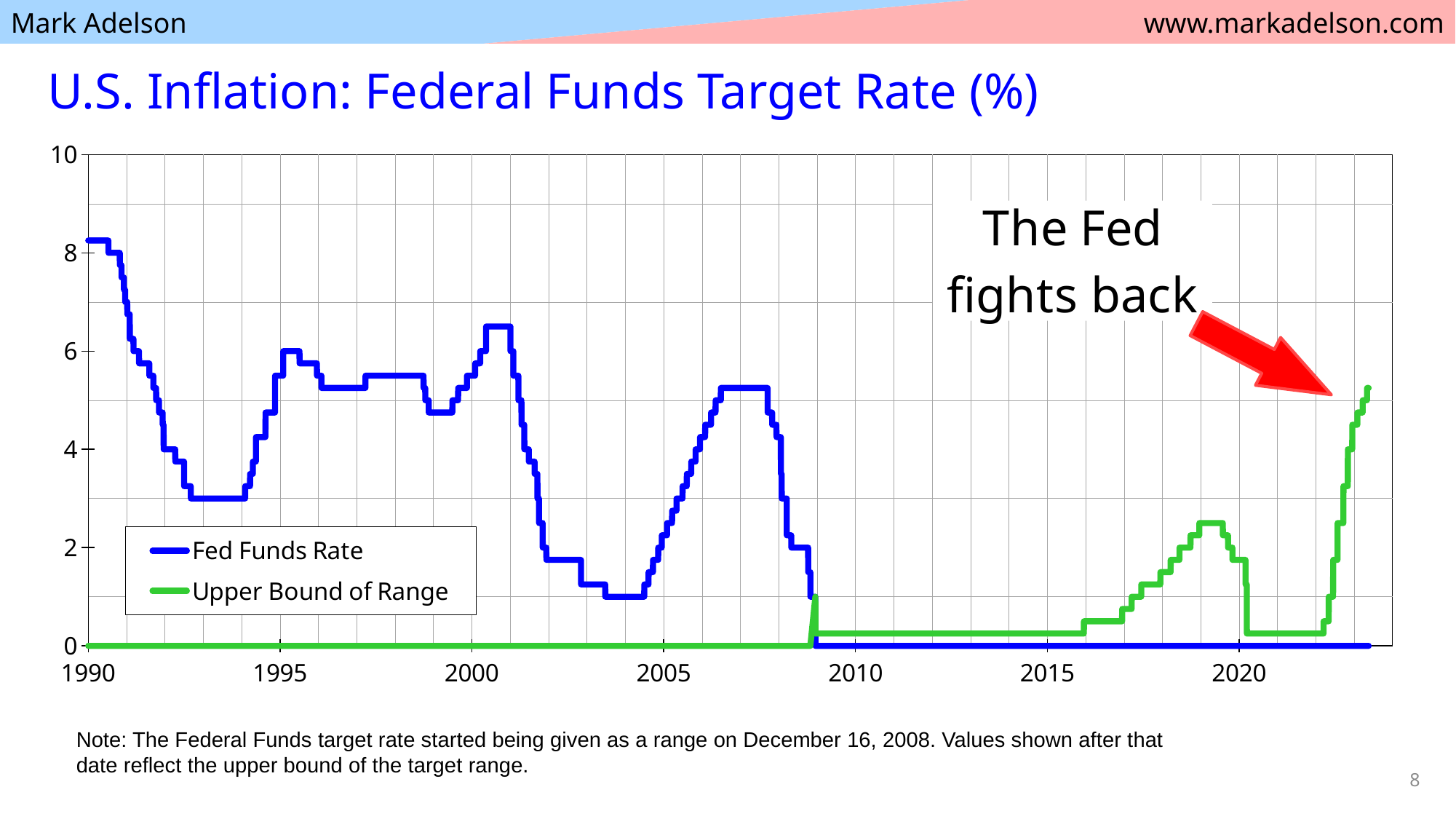
What colour is the Upper Bound of Range line? Green Is the Fed Funds Rate at the start of 1990 greater or less than 8? greater Does the Fed Funds Rate rise or fall between 1990 and 1993? Fall Is the Upper Bound of Range in 2015 greater or less than 2? less What are the two series named in the legend? Fed Funds Rate and Upper Bound of Range Is the Fed Funds Rate in 2004 greater or less than 2? less What kind of chart is shown on the slide? Line chart Which series reaches the higher peak value on the chart, Fed Funds Rate or Upper Bound of Range? Fed Funds Rate Does the Upper Bound of Range rise or fall between 2022 and 2023? Rise How many series does the legend list? 2